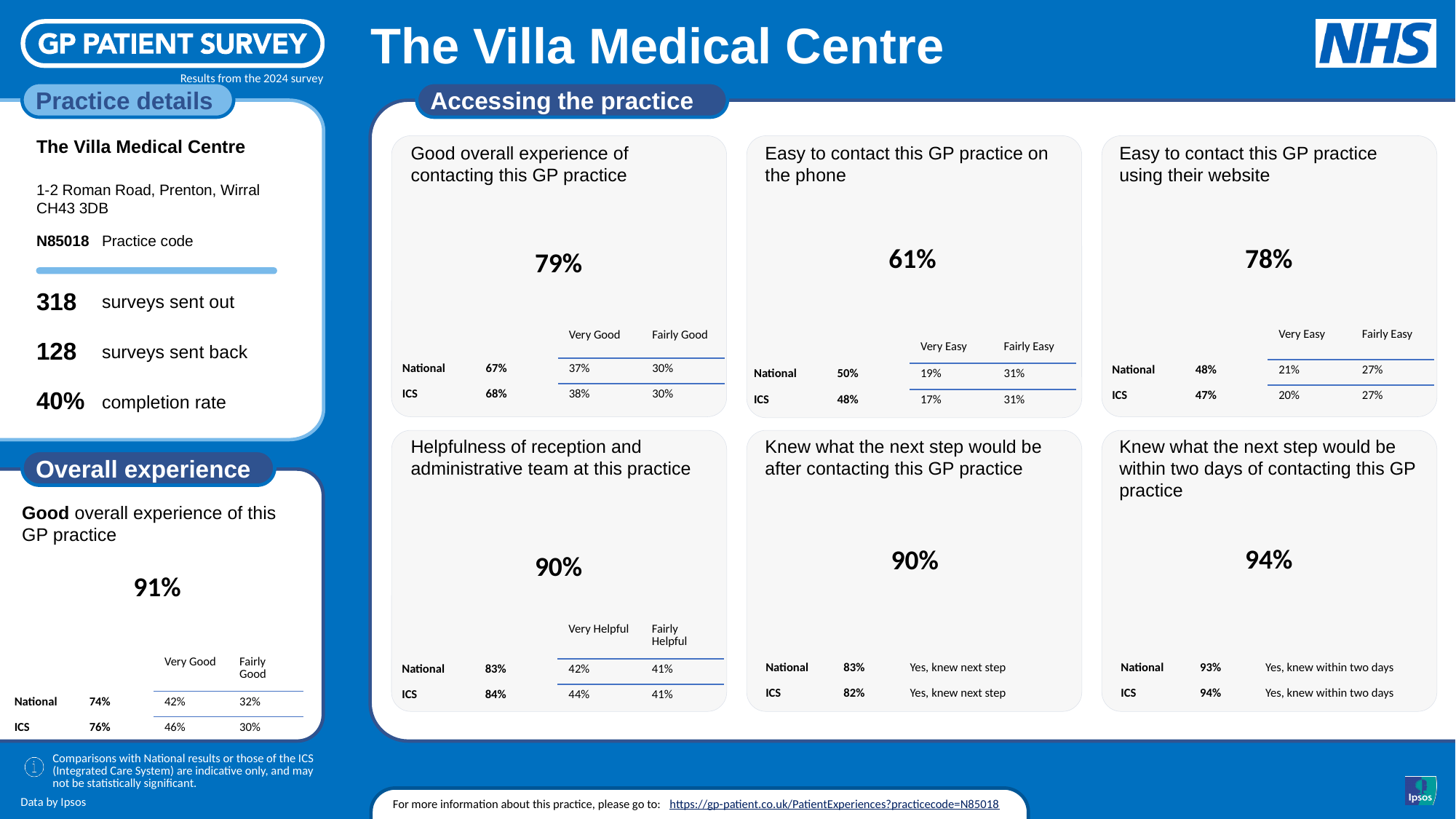
In the 'Good overall experience of this GP practice' panel under Overall experience, what is the practice's headline percentage? 91% How many question panels are shown under the 'Accessing the practice' heading? 6 In the 'Good overall experience of contacting this GP practice' panel, what is the practice's headline percentage? 79% In the 'Easy to contact this GP practice on the phone' panel, what is the National value? 50% In the 'Easy to contact this GP practice on the phone' panel, what is the difference between the practice's 61% and the National 50%? 11 percentage points In the 'Knew what the next step would be within two days of contacting this GP practice' panel, what is the ICS value? 94% Across the six 'Accessing the practice' panels, which question has the highest practice headline percentage? Knew what the next step would be within two days of contacting this GP practice In the 'Easy to contact this GP practice using their website' panel, what is the ICS 'Very Easy' value? 20% In the 'Good overall experience of contacting this GP practice' panel, what is the total of the National 'Very Good' and 'Fairly Good' values? 67% In the 'Good overall experience of this GP practice' panel, which is larger: the National value or the ICS value? ICS In the 'Helpfulness of reception and administrative team at this practice' panel, what is the National 'Very Helpful' value? 42% Across the six 'Accessing the practice' panels, which question has the lowest practice headline percentage? Easy to contact this GP practice on the phone